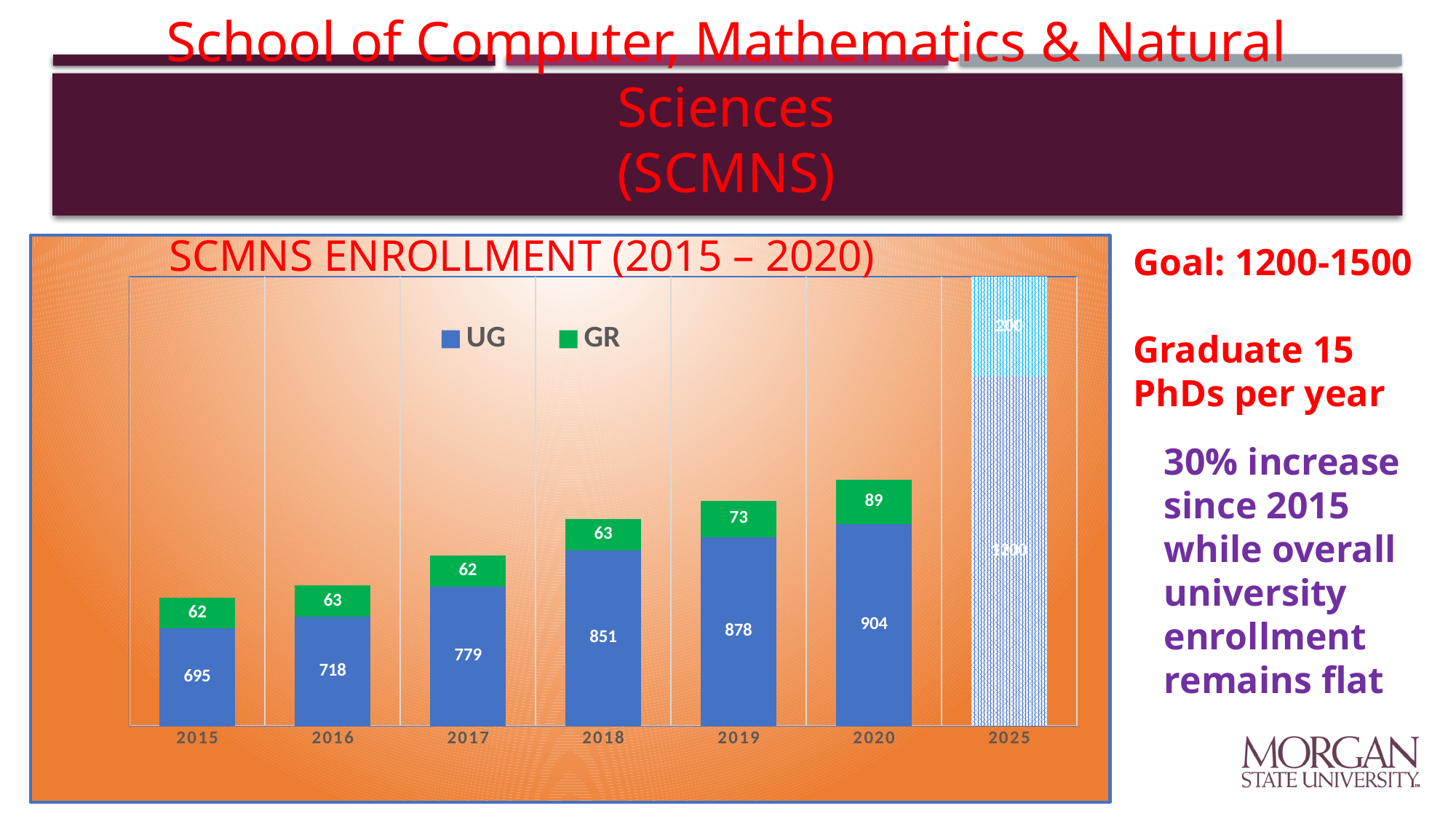
How many years are labeled on the x axis? 7 Which is larger, the GR enrollment in 2018 or in 2019? 2019 What is the UG enrollment value for 2015? 695 What is the total enrollment (UG plus GR) for 2020? 993 Which year has the lowest UG enrollment? 2015 What is the difference between the UG enrollment in 2020 and in 2015? 209 What is the GR enrollment value for 2019? 73 Does UG enrollment rise or fall from 2015 to 2020? rise What type of chart is shown on the slide? stacked bar chart What is the UG enrollment value for 2017? 779 How many series does the legend list? 2 Which year has the highest GR enrollment? 2025